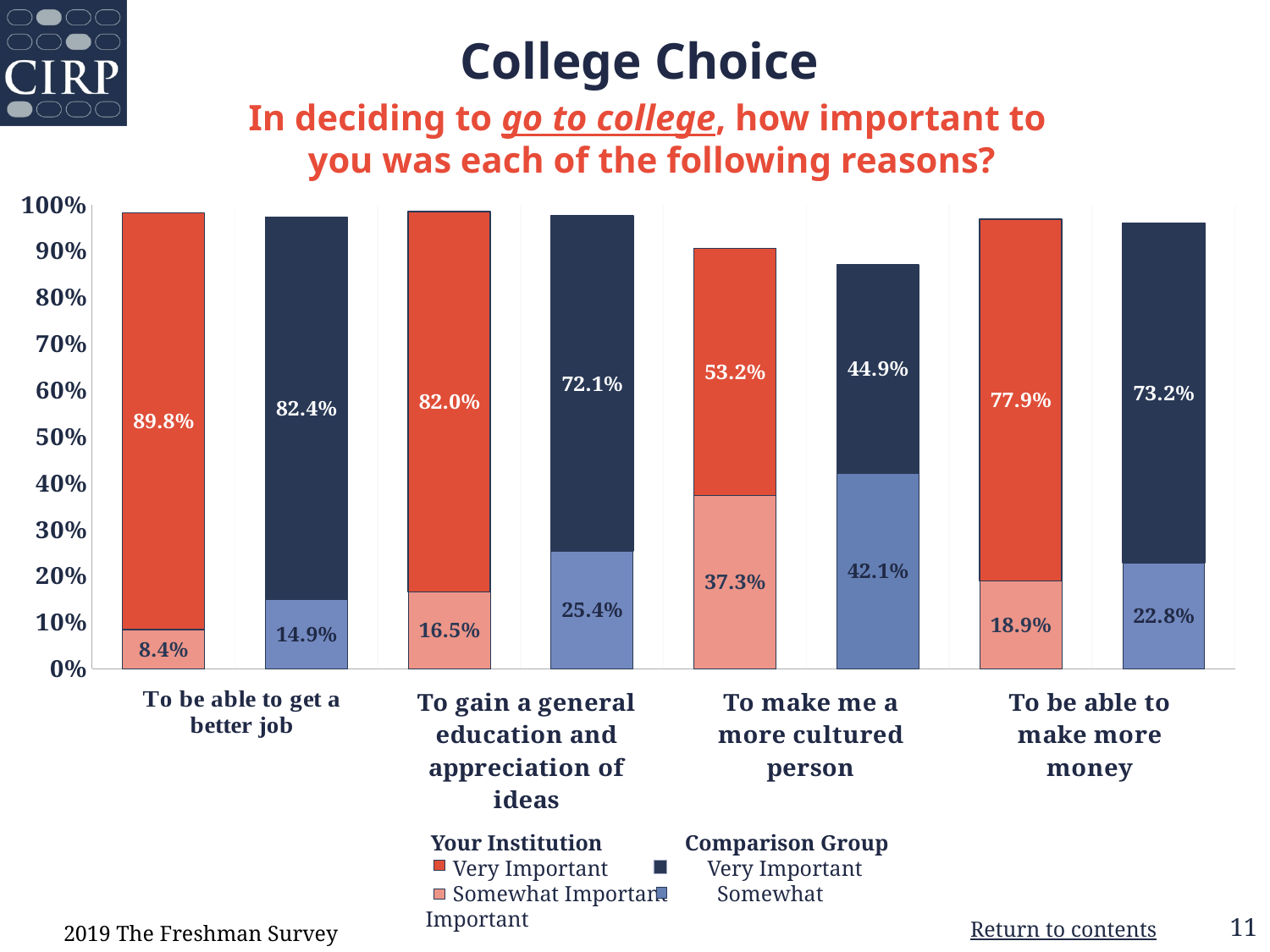
What percentage of the Comparison Group rated "To make me a more cultured person" as Somewhat Important? 42.1% How many reasons (categories) are shown on the x axis? 4 Which is larger: the Comparison Group Very Important percentage for "To be able to make more money" or for "To gain a general education and appreciation of ideas"? To be able to make more money What percentage of Your Institution students rated "To be able to make more money" as Somewhat Important? 18.9% What kind of chart is shown on the slide? Stacked bar chart What percentage of Your Institution students rated "To be able to get a better job" as Very Important? 89.8% What is the difference between the Your Institution and Comparison Group Very Important percentages for "To gain a general education and appreciation of ideas"? 9.9 percentage points Which reason has the highest Very Important percentage for Your Institution? To be able to get a better job Which reason has the lowest Very Important percentage for the Comparison Group? To make me a more cultured person How many series does the legend list? 4 What is the total of the Comparison Group stacked bar for "To be able to get a better job"? 97.3% What is the total of the Your Institution stacked bar for "To make me a more cultured person"? 90.5%